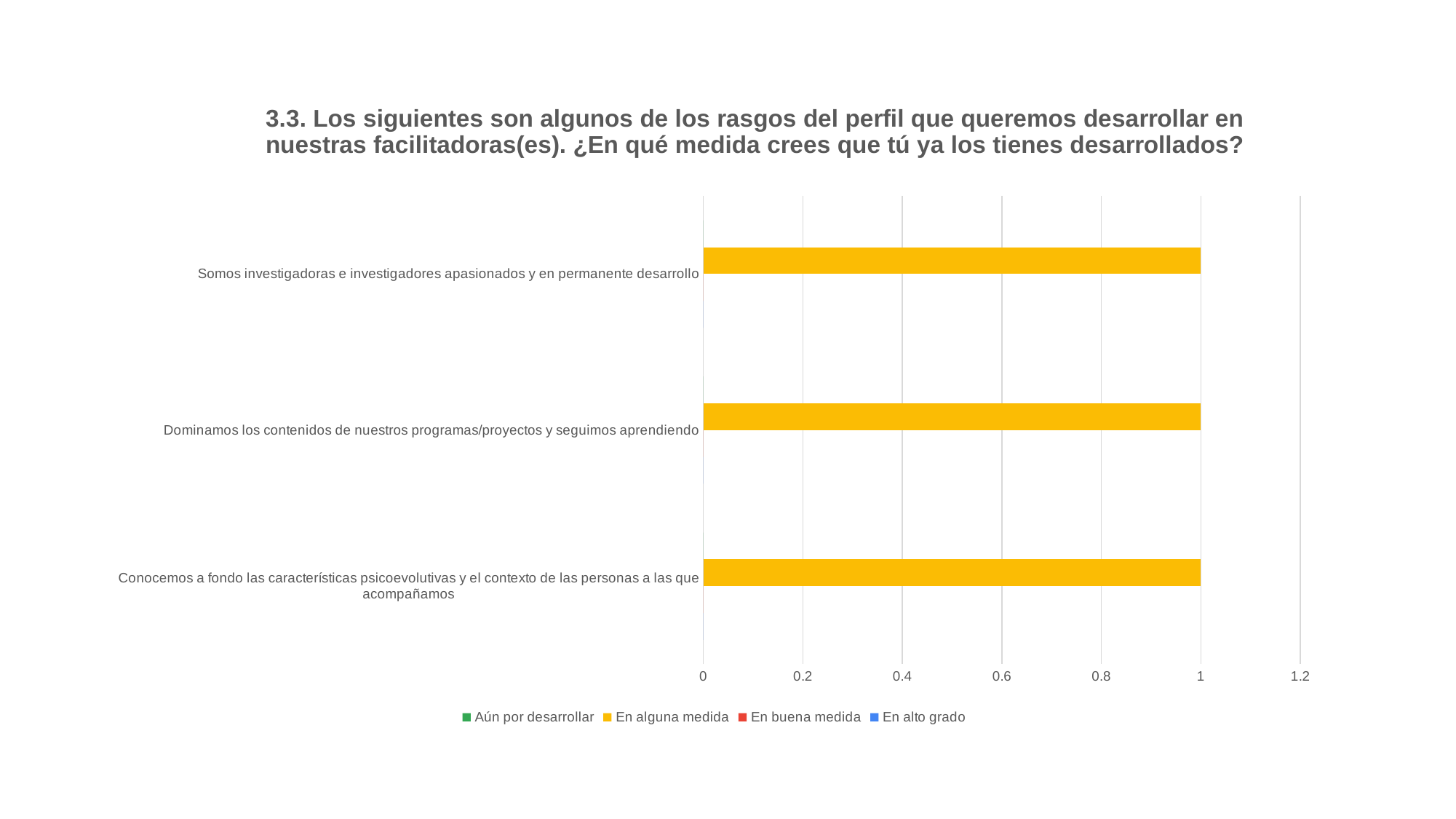
What is the difference between the 'En alguna medida' values for 'Somos investigadoras e investigadores apasionados y en permanente desarrollo' and 'Dominamos los contenidos de nuestros programas/proyectos y seguimos aprendiendo'? 0 How many categories (profile traits) are plotted on the chart? 3 Which legend series is shown in yellow? En alguna medida Which series is the only one with visible bars on the chart? En alguna medida Is the 'En alguna medida' value for 'Dominamos los contenidos de nuestros programas/proyectos y seguimos aprendiendo' greater or less than 0.6? greater What is the value of 'En alguna medida' for 'Somos investigadoras e investigadores apasionados y en permanente desarrollo'? 1 What is the value of 'En alguna medida' for 'Conocemos a fondo las características psicoevolutivas y el contexto de las personas a las que acompañamos'? 1 How many series does the legend list? 4 Is the 'En alguna medida' value for 'Somos investigadoras e investigadores apasionados y en permanente desarrollo' greater or less than 1.2? less What is the value of 'En alguna medida' for 'Dominamos los contenidos de nuestros programas/proyectos y seguimos aprendiendo'? 1 What kind of chart is shown on the slide? bar chart